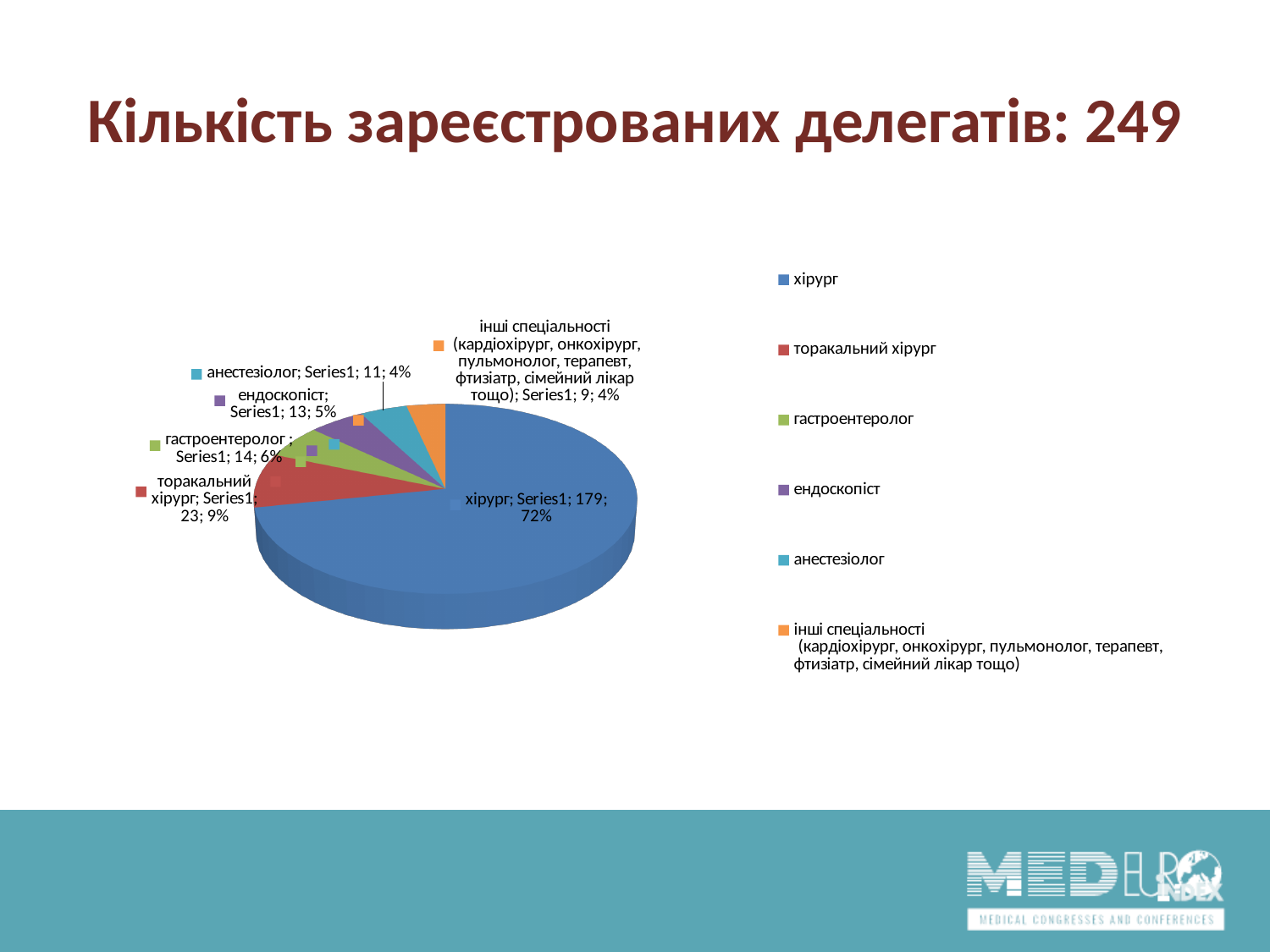
Which category has the smallest value in the pie chart? інші спеціальності How many entries does the legend list? 6 What value is shown for торакальний хірург? 23 What percentage share is shown for the хірург slice? 72% What kind of chart is shown on the slide? pie chart Which is larger, the value for гастроентеролог or the value for ендоскопіст? гастроентеролог How many delegates are labelled for the хірург slice? 179 Which category has the largest slice of the pie? хірург What value is shown for ендоскопіст? 13 What is the difference between the values for хірург and торакальний хірург? 156 What percentage share is shown for анестезіолог? 4% What value is shown for гастроентеролог? 14